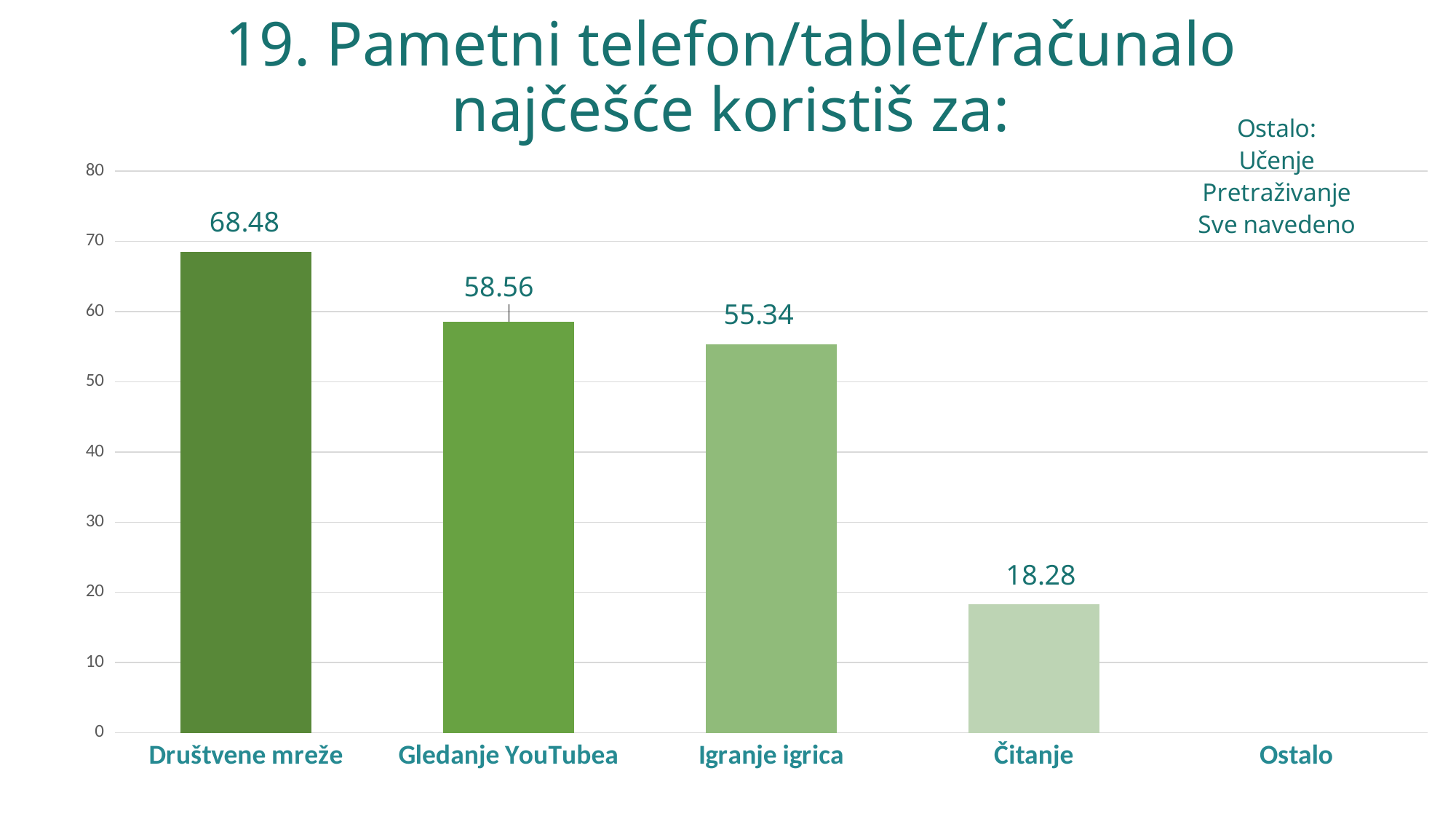
What is the difference between the values for Igranje igrica and Čitanje? 37.06 What kind of chart is shown on the slide? bar chart Which is larger, the value for Gledanje YouTubea or the value for Igranje igrica? Gledanje YouTubea Which category with a plotted bar has the lowest value? Čitanje What is the value for Gledanje YouTubea? 58.56 What is the value for Društvene mreže? 68.48 Which category has the highest value? Društvene mreže What is the difference between the values for Društvene mreže and Gledanje YouTubea? 9.92 How many category labels are shown on the x axis? 5 What is the value for Čitanje? 18.28 Do the bar values rise or fall from left to right along the x axis? fall Is the value for Čitanje greater or less than 20? less